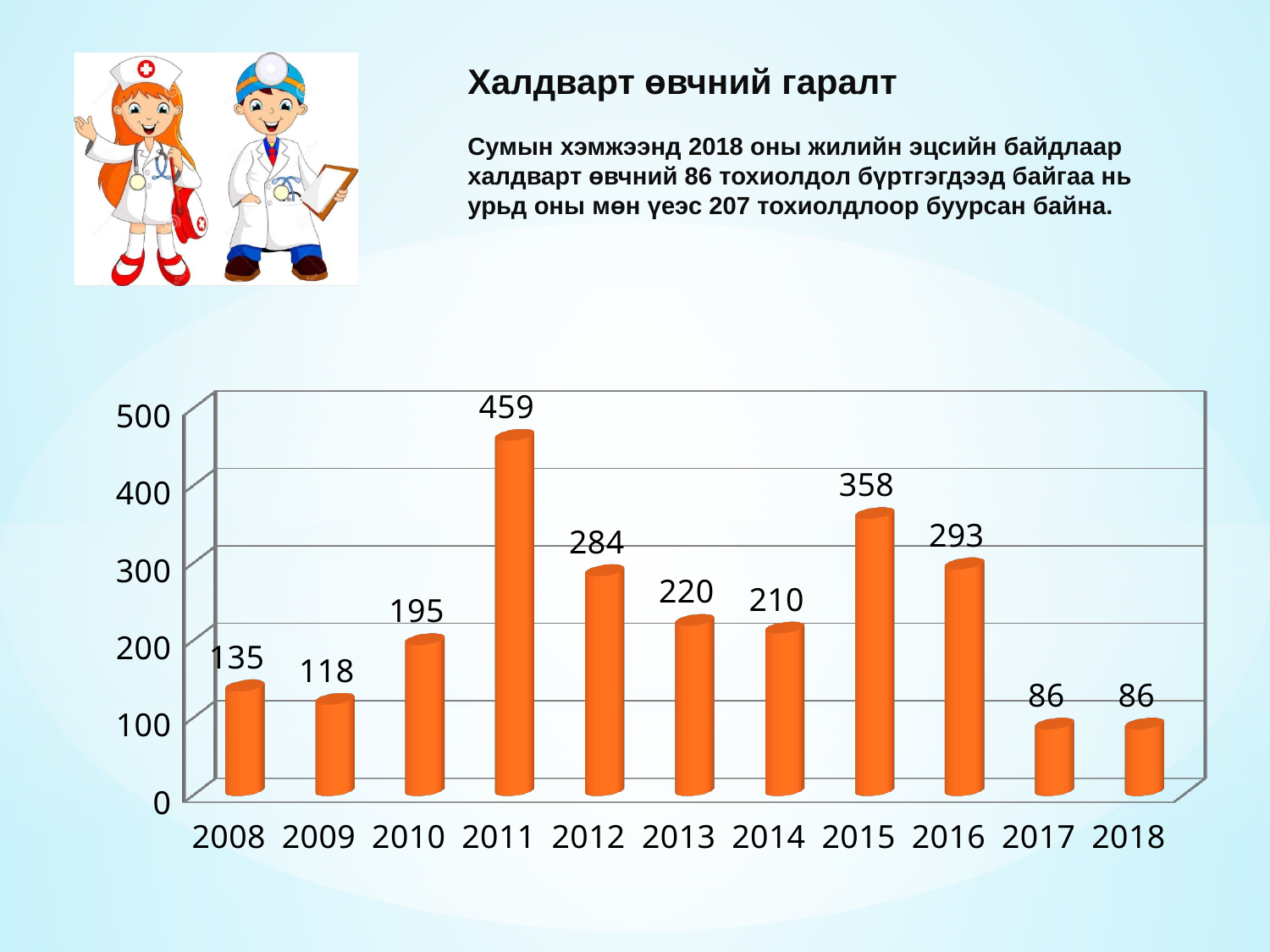
What is the value for 2015? 358 Is the value for 2010 greater or less than 200? less How many years are shown on the x axis? 11 What kind of chart is shown on the slide? bar chart What is the value for 2011? 459 What is the lowest value shown on the chart? 86 What is the difference between the values for 2016 and 2017? 207 What is the difference between the values for 2011 and 2012? 175 Which is larger, the value for 2013 or the value for 2014? 2013 Do the values rise or fall from 2015 to 2018? fall What is the value for 2009? 118 Which year has the highest value? 2011